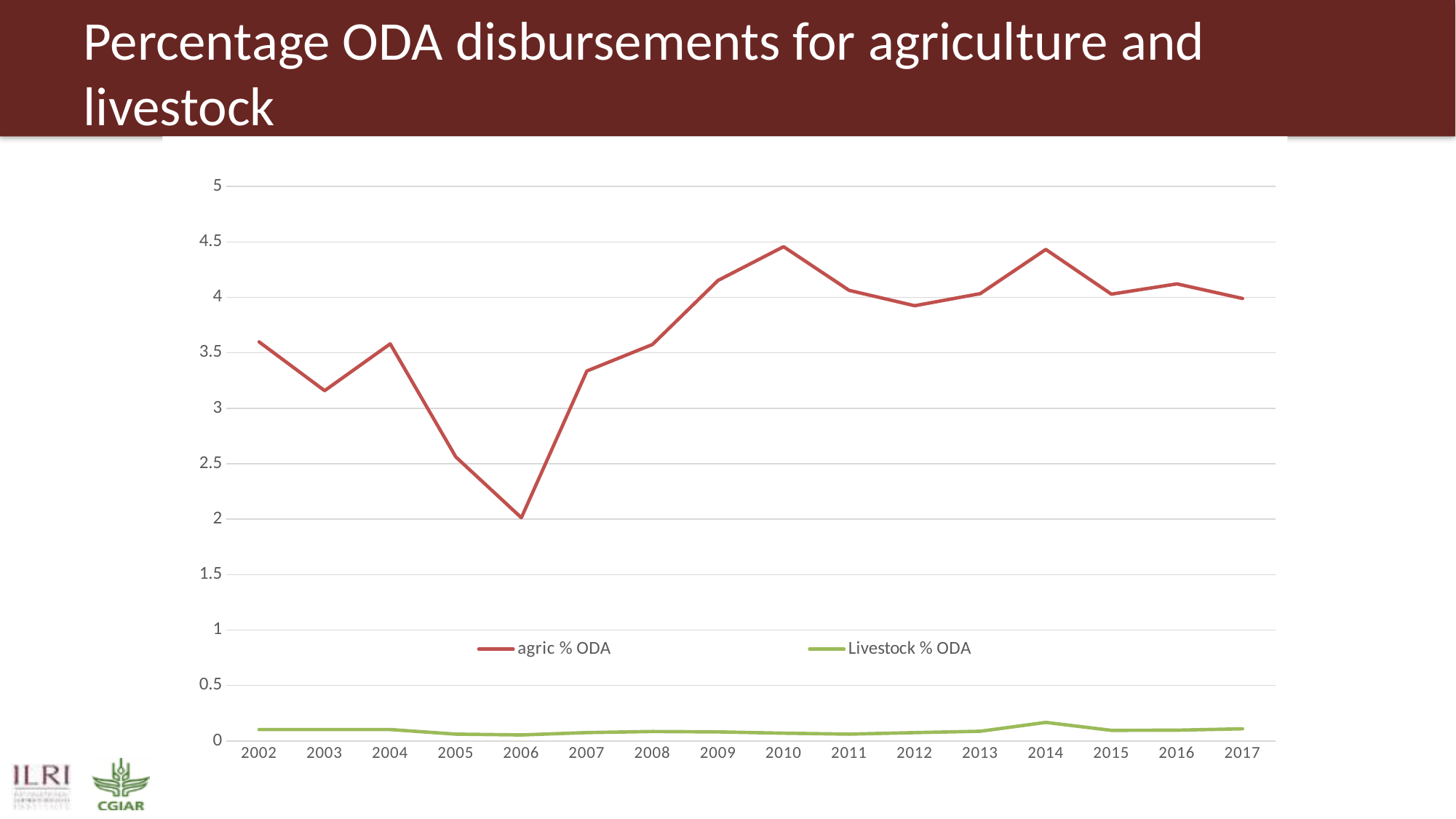
Is the Livestock % ODA value for 2014 greater or less than 0.5? less Does the agric % ODA line rise or fall from 2006 to 2010? rise In which year is the Livestock % ODA value highest? 2014 Is the agric % ODA value for 2006 greater or less than 2.5? less What colour is the Livestock % ODA line? green How many series does the legend list? 2 What kind of chart is shown on the slide? line chart In which year is the agric % ODA value lowest? 2006 How many years are plotted along the x axis? 16 Which is larger, the agric % ODA value for 2002 or for 2003? 2002 Is the agric % ODA value for 2003 greater or less than 3? greater